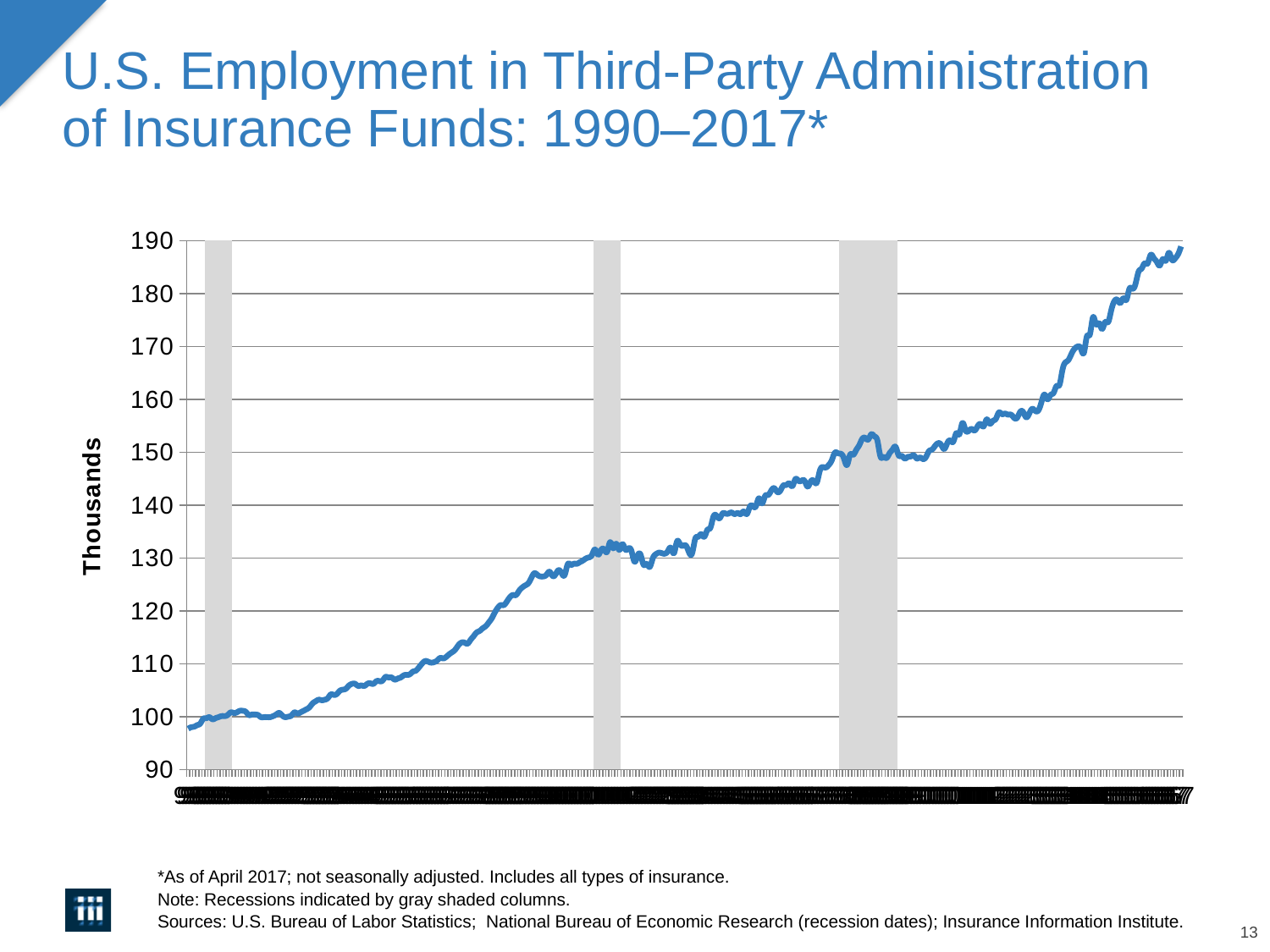
At which end of the series, the start (1990) or the end (2017), does the line reach its lowest value? the start (1990) How many gray shaded recession columns are shown on the chart? 3 Is the value at the right-hand end of the line greater or less than 190? less Is the value at the end of the line (2017) larger or smaller than the value at the start (1990)? larger Overall, do the values rise or fall from left to right along the x axis? rise At which end of the series, the start (1990) or the end (2017), does the line reach its highest value? the end (2017) Is the value at the left-hand start of the line (1990) greater or less than 110? less Is the value at the right-hand end of the line (2017) greater or less than 180? greater What kind of chart is shown on the slide? line chart What is the label on the vertical axis? Thousands